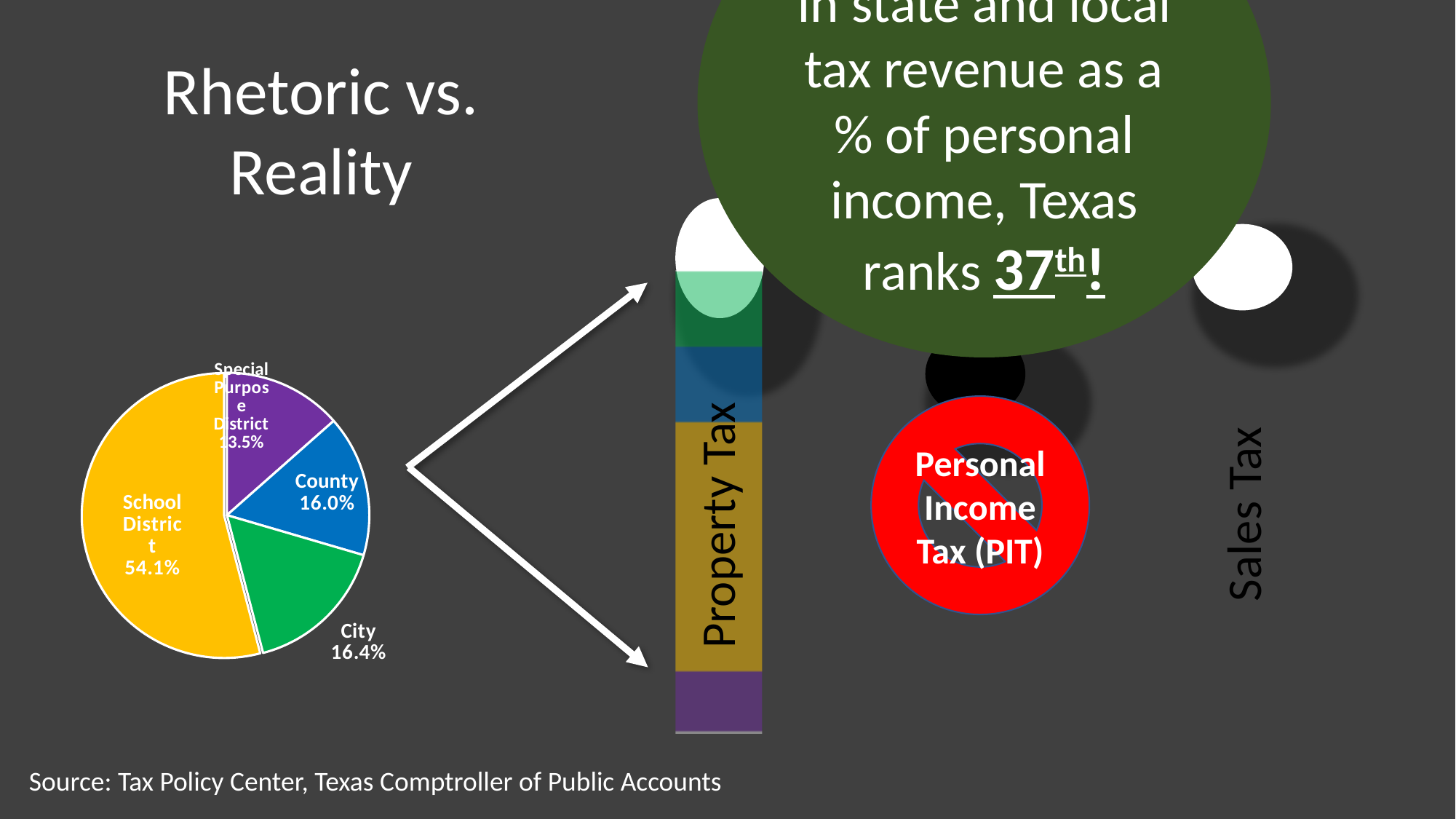
What is the difference between the City and Special Purpose District shares in the pie chart? 2.9% What is the value shown for City in the pie chart? 16.4% Which category has the smallest slice of the pie chart? Special Purpose District How many categories are shown in the pie chart? 4 What share of the pie chart does School District account for? 54.1% What colour is the School District slice in the pie chart? Yellow In the pie chart, which is larger, City or County? City What is the value shown for Special Purpose District in the pie chart? 13.5% What is the value shown for County in the pie chart? 16.0% What kind of chart is shown on the left of the slide? Pie chart What is the difference between the School District and County shares in the pie chart? 38.1% Which category has the largest slice of the pie chart? School District